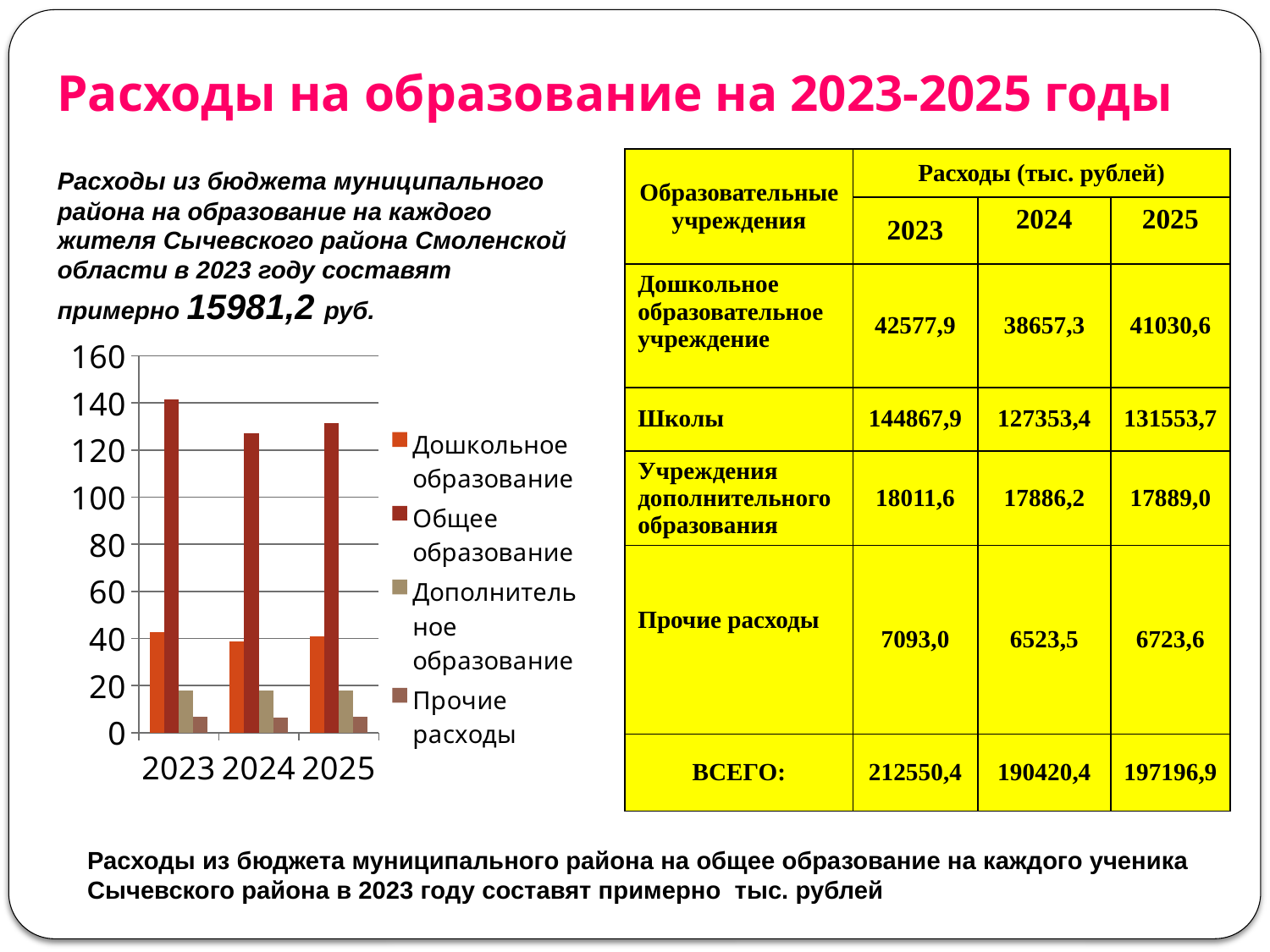
Is the value for Общее образование in 2023 greater or less than 120? greater Which is larger: Общее образование in 2023 or Общее образование in 2024? Общее образование in 2023 Is the value for Дополнительное образование in 2024 greater or less than 40? less Is the value for Общее образование in 2024 greater or less than 140? less How many series does the chart legend list? 4 Which series is shown in dark red in the chart legend? Общее образование What kind of chart is shown on the slide? bar chart Which series has the highest bar in 2023? Общее образование How many years are shown on the x axis of the chart? 3 Which series has the lowest bar in 2025? Прочие расходы